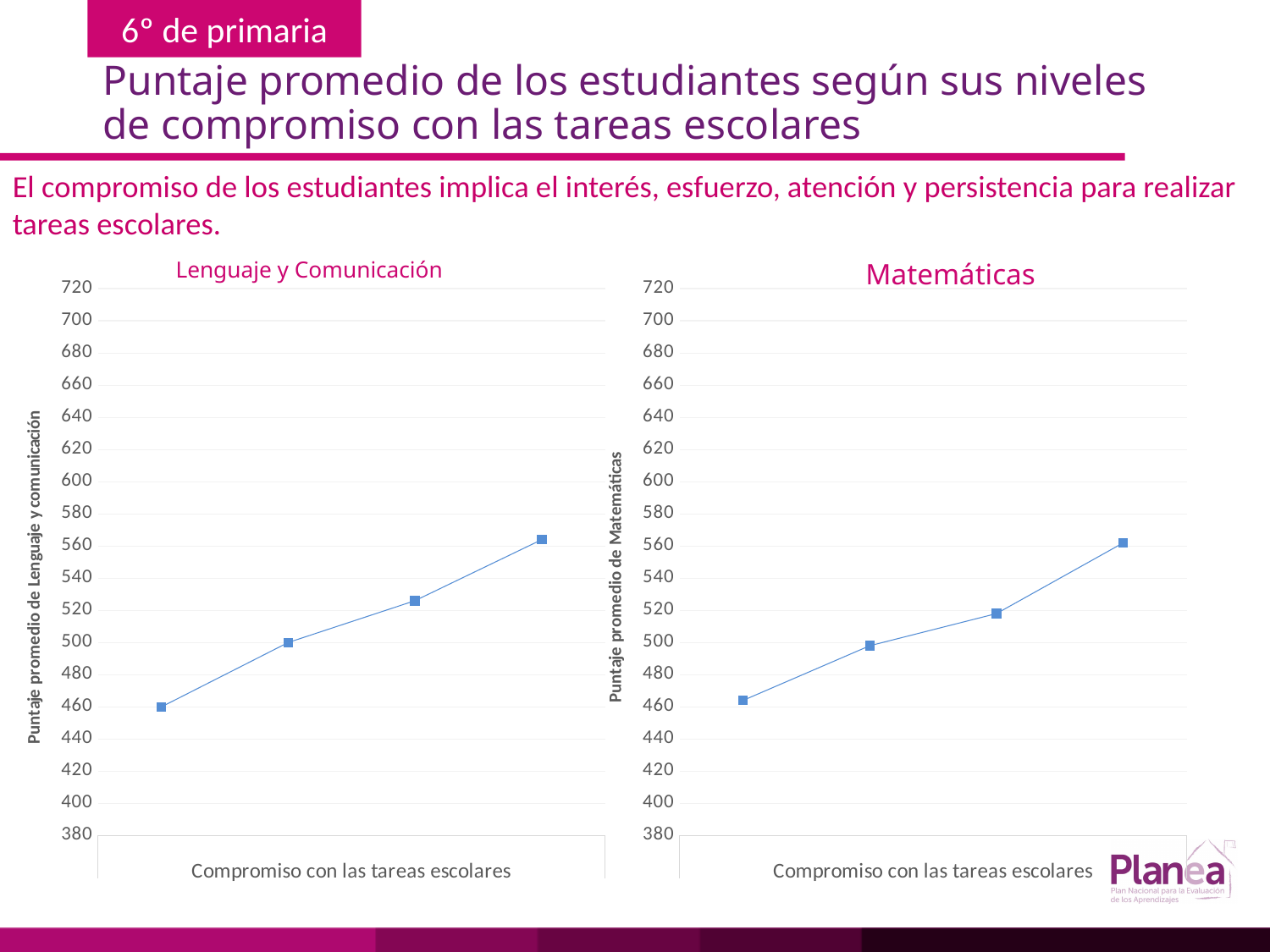
On the 'Matemáticas' chart, do the values rise or fall from left to right along the x axis? rise What kind of chart is the 'Matemáticas' chart? line chart On the 'Lenguaje y Comunicación' chart, do the values rise or fall from left to right along the x axis? rise What kind of chart is the 'Lenguaje y Comunicación' chart? line chart How many data points are plotted on the 'Lenguaje y Comunicación' chart? 4 On the 'Lenguaje y Comunicación' chart, is the value of the leftmost point greater or less than 480? less What is the y-axis label on the 'Lenguaje y Comunicación' chart? Puntaje promedio de Lenguaje y comunicación What is the x-axis label on the 'Matemáticas' chart? Compromiso con las tareas escolares On the 'Matemáticas' chart, is the value of the rightmost point greater or less than 540? greater On the 'Lenguaje y Comunicación' chart, is the value of the rightmost point greater or less than 540? greater How many data points are plotted on the 'Matemáticas' chart? 4